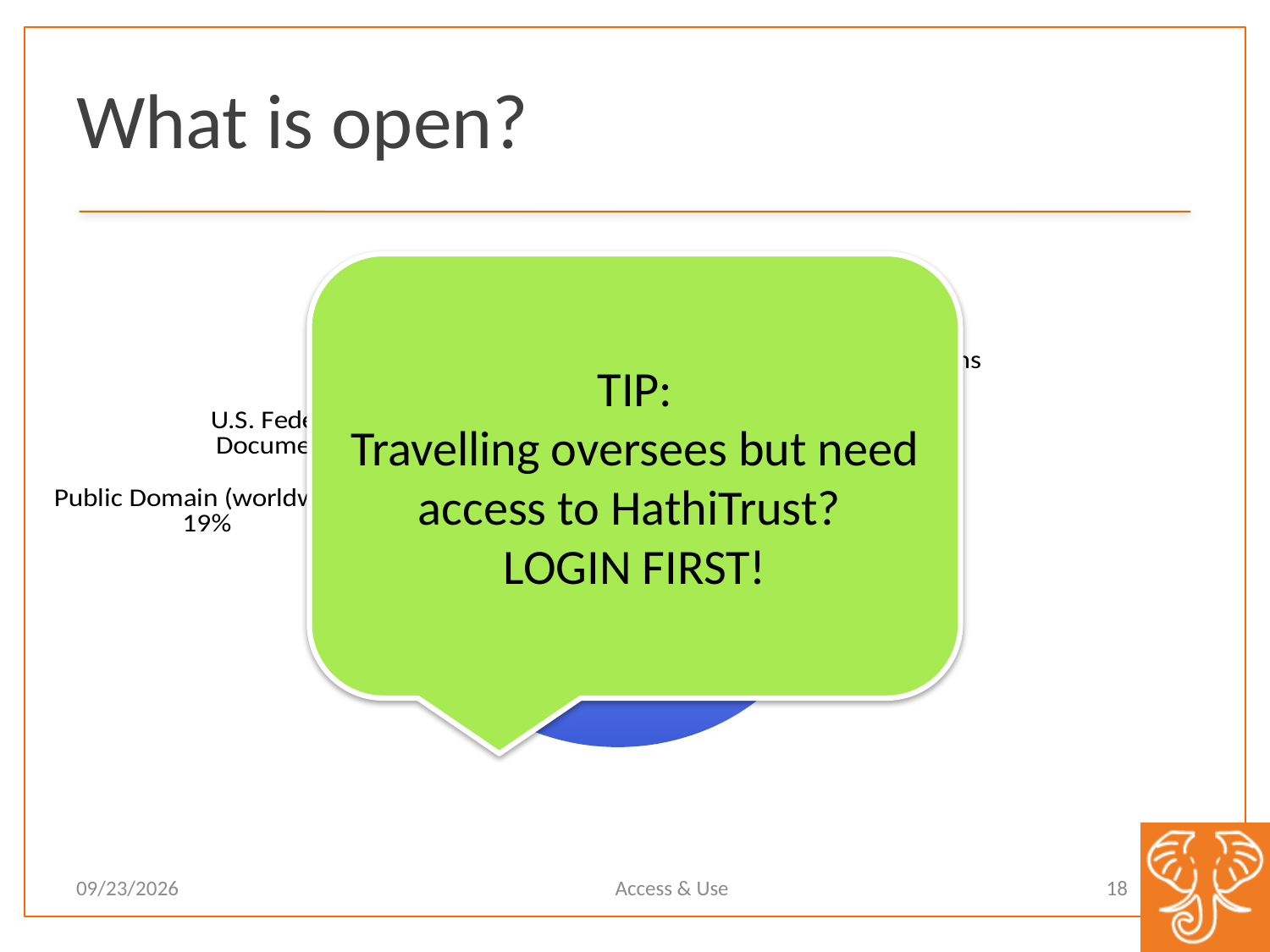
What is the share of the pie chart labelled Public Domain? 19% What kind of chart is partially visible behind the green callout on the slide? pie chart What percentage is shown for the Public Domain slice of the pie chart? 19%